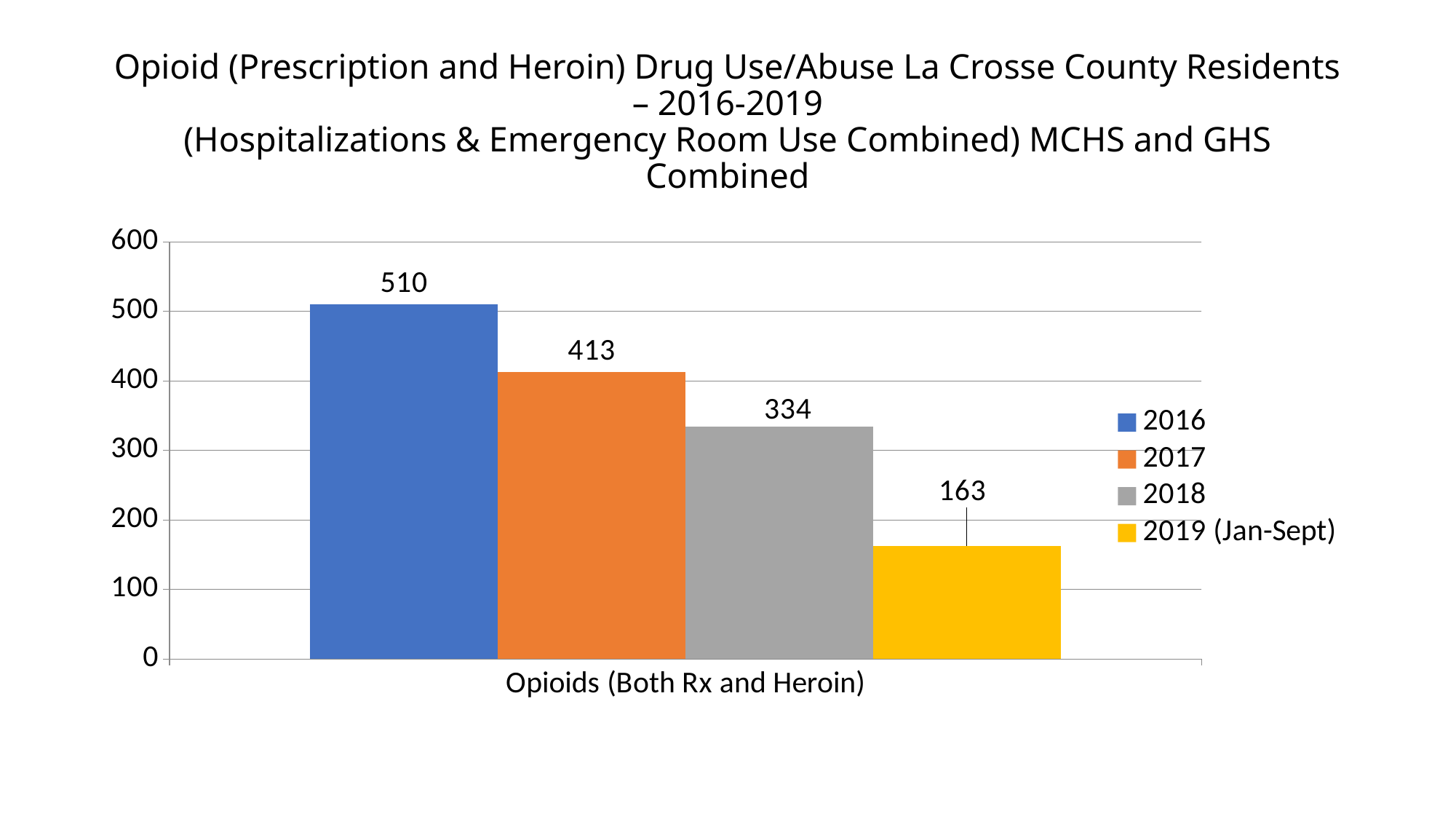
What is the difference between the 2018 and 2019 (Jan-Sept) values? 171 How many series does the legend list? 4 What is the value for 2017? 413 What is the value for 2018? 334 Do the values rise or fall from 2016 to 2019 (Jan-Sept)? Fall What is the value for 2016? 510 What is the difference between the 2016 and 2017 values? 97 What kind of chart is shown? Bar chart Which series has the lowest value? 2019 (Jan-Sept) Which year has the highest value? 2016 Which is larger, the value for 2017 or the value for 2018? 2017 What is the value for 2019 (Jan-Sept)? 163